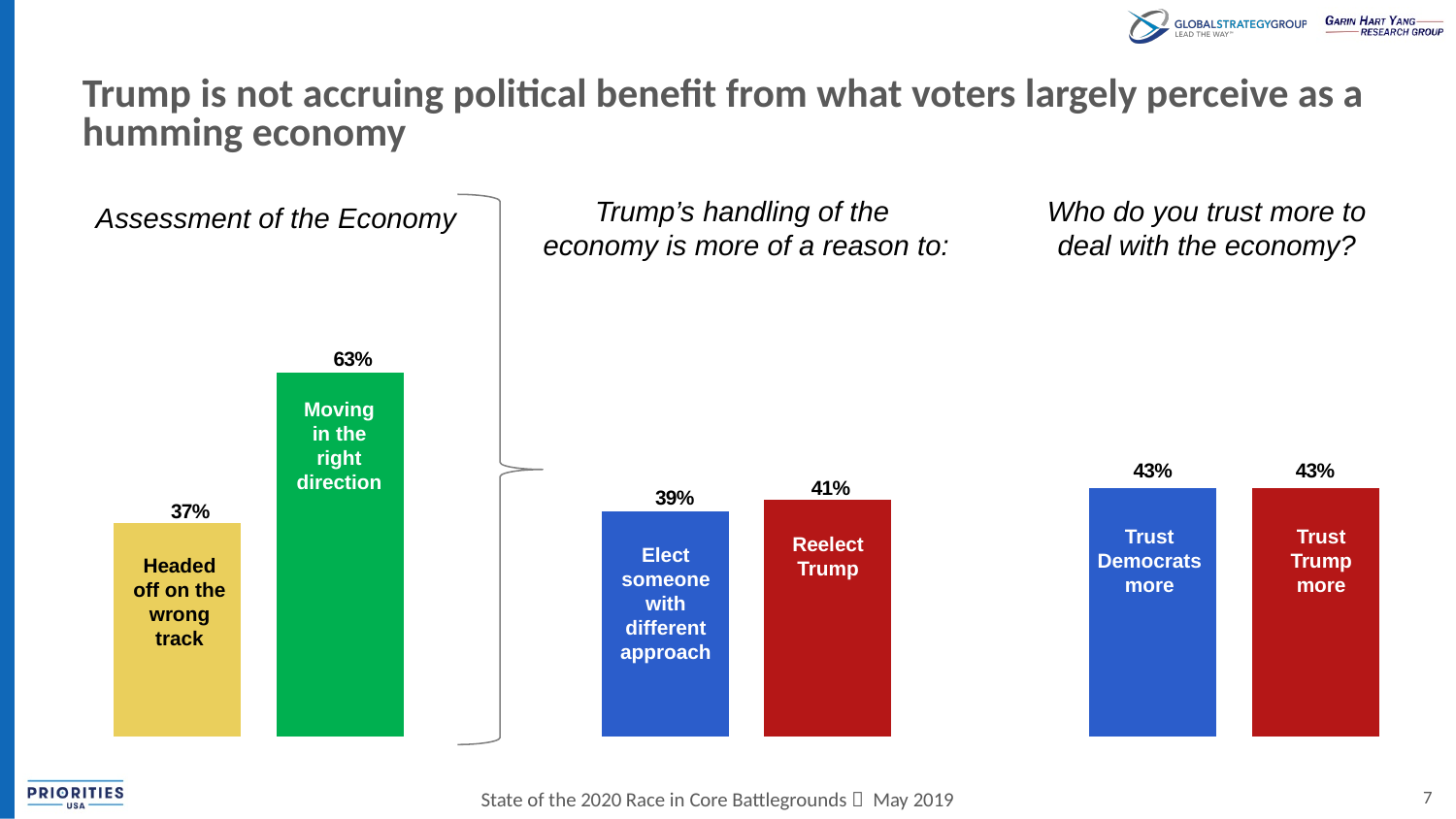
In the 'Who do you trust more to deal with the economy?' chart, how many bars are shown? 2 What type of chart is the 'Assessment of the Economy' chart? Bar chart In the 'Trump's handling of the economy is more of a reason to:' chart, what percentage say 'Reelect Trump'? 41% In the 'Assessment of the Economy' chart, which category has the higher value? Moving in the right direction In the 'Assessment of the Economy' chart, what percentage say the economy is moving in the right direction? 63% In the 'Assessment of the Economy' chart, what is the difference between 'Moving in the right direction' and 'Headed off on the wrong track'? 26 percentage points In the 'Who do you trust more to deal with the economy?' chart, what percentage trust Trump more? 43% In the 'Assessment of the Economy' chart, what colour is the 'Moving in the right direction' bar? Green In the 'Trump's handling of the economy is more of a reason to:' chart, what percentage say 'Elect someone with different approach'? 39% In the 'Assessment of the Economy' chart, what percentage say the economy is headed off on the wrong track? 37% In the 'Trump's handling of the economy is more of a reason to:' chart, what is the difference between 'Reelect Trump' and 'Elect someone with different approach'? 2 percentage points In the 'Who do you trust more to deal with the economy?' chart, what percentage trust Democrats more? 43%